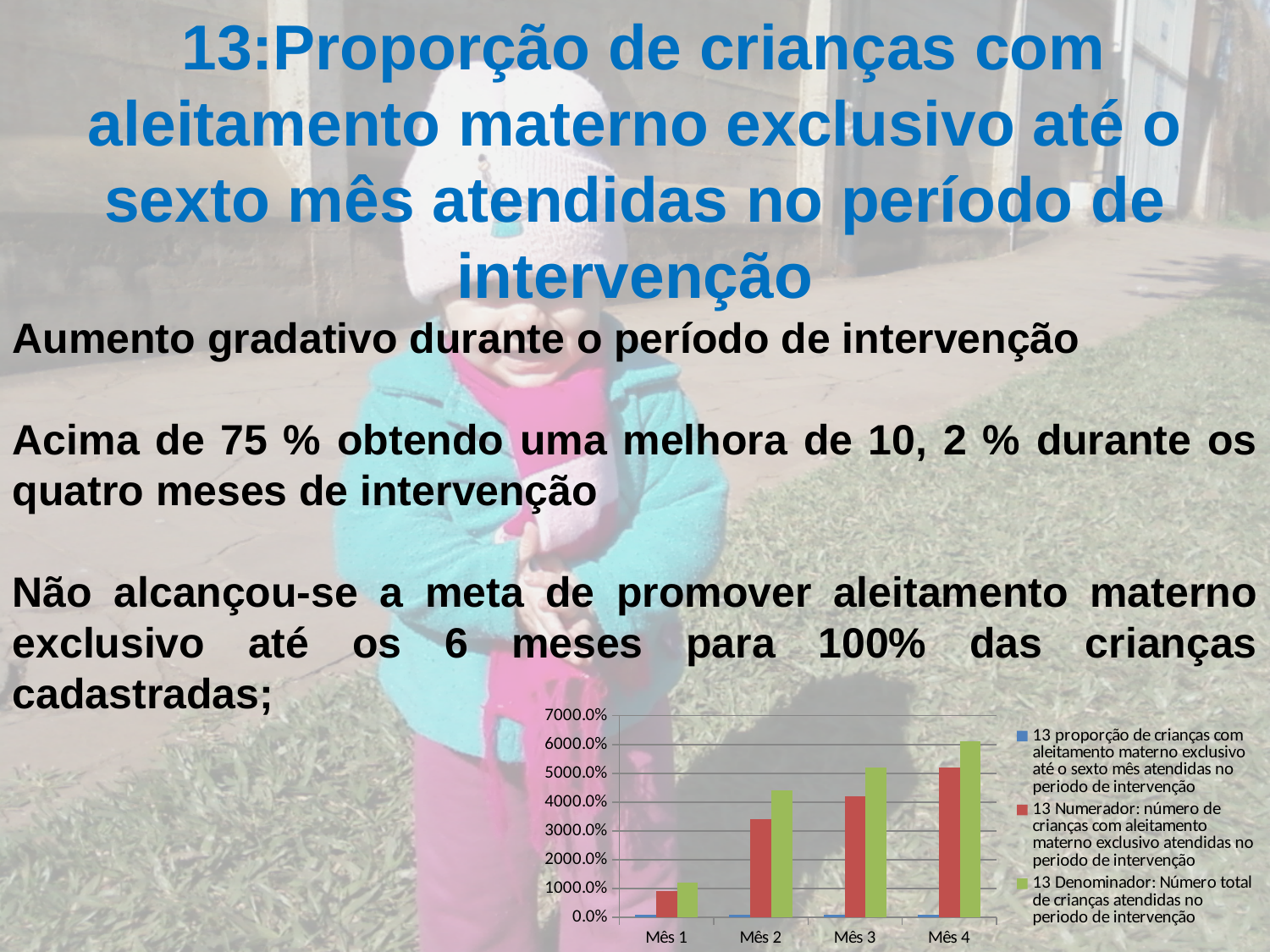
Which month has the lowest value for the '13 Numerador' series (red bars)? Mês 1 Which month has the highest value for the '13 Denominador' series (green bars)? Mês 4 What colour are the bars for the '13 Denominador' series in the chart? green Is the value of the green bar for Mês 4 greater or less than 5000.0%? greater How many series does the chart legend list? 3 Do the values of the '13 Numerador' series (red bars) rise or fall from Mês 1 to Mês 4? rise What kind of chart is shown on the slide? bar chart Is the value of the red bar for Mês 1 greater or less than 1000.0%? less Is the value of the green bar for Mês 2 greater or less than 4000.0%? greater How many categories (months) are shown on the x axis of the chart? 4 Which is larger in Mês 3: the red bar (Numerador) or the green bar (Denominador)? green bar (Denominador) Which month has the lowest value for the '13 Denominador' series (green bars)? Mês 1